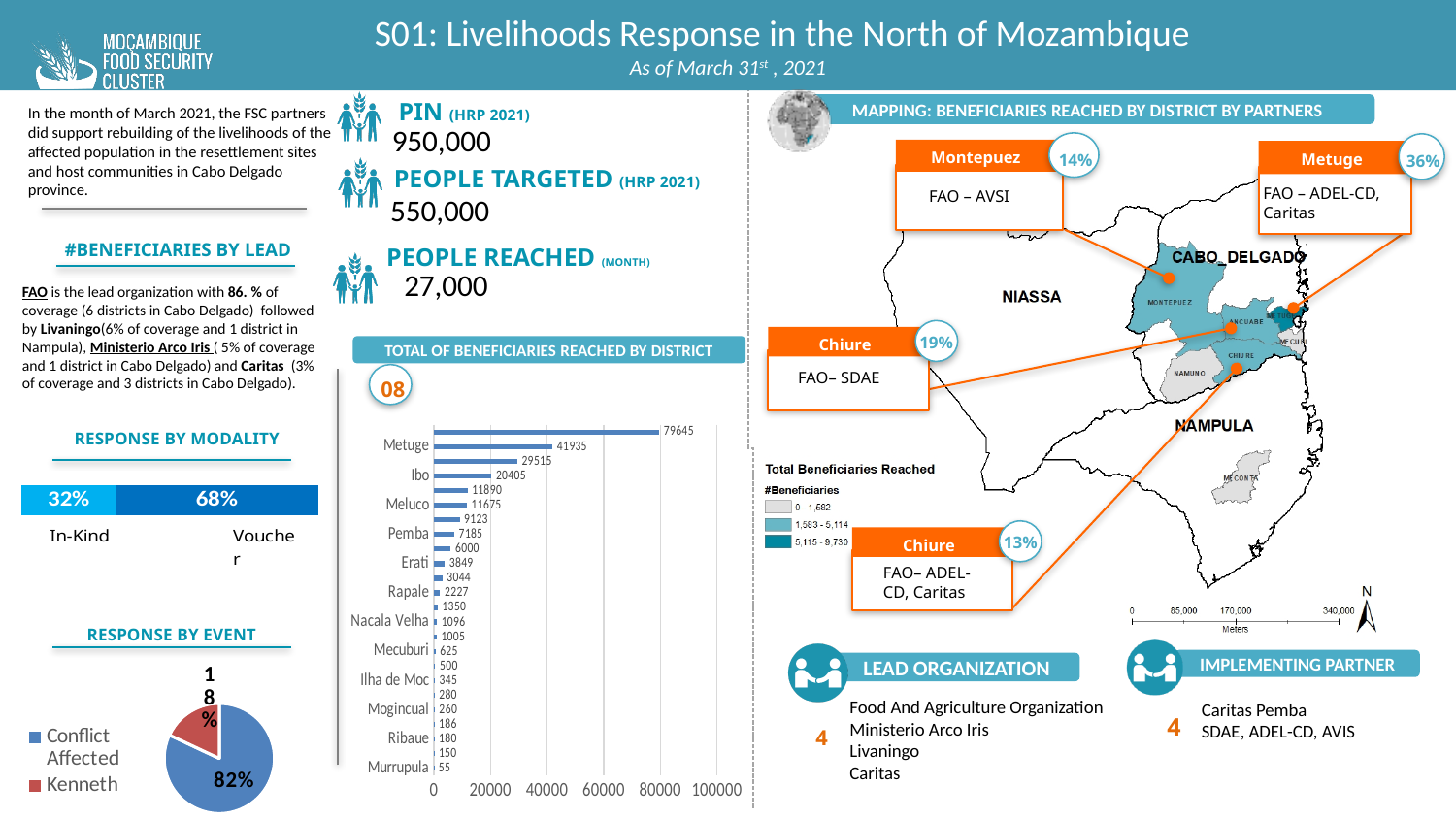
In the 'RESPONSE BY EVENT' pie chart, what share is labelled for Kenneth? 18% In the 'RESPONSE BY MODALITY' graphic, what percentage is shown for In-Kind? 32% In the 'RESPONSE BY EVENT' pie chart, what share is labelled for Conflict Affected? 82% In the 'TOTAL OF BENEFICIARIES REACHED BY DISTRICT' bar chart, what is the largest value labelled on any bar? 79645 In the 'RESPONSE BY MODALITY' graphic, which modality has the larger share, In-Kind or Voucher? Voucher What kind of chart is 'RESPONSE BY EVENT'? Pie chart What kind of chart is 'TOTAL OF BENEFICIARIES REACHED BY DISTRICT'? Bar chart In the 'RESPONSE BY MODALITY' graphic, what percentage is shown for Voucher? 68% In the 'RESPONSE BY EVENT' pie chart, how many entries does the legend list? 2 In the 'RESPONSE BY EVENT' pie chart, what is the difference in percentage points between the Kenneth slice and the Conflict Affected slice? 64 In the 'TOTAL OF BENEFICIARIES REACHED BY DISTRICT' bar chart, what is the smallest value labelled on any bar? 55 In the 'RESPONSE BY EVENT' pie chart, which category has the larger slice, Conflict Affected or Kenneth? Conflict Affected